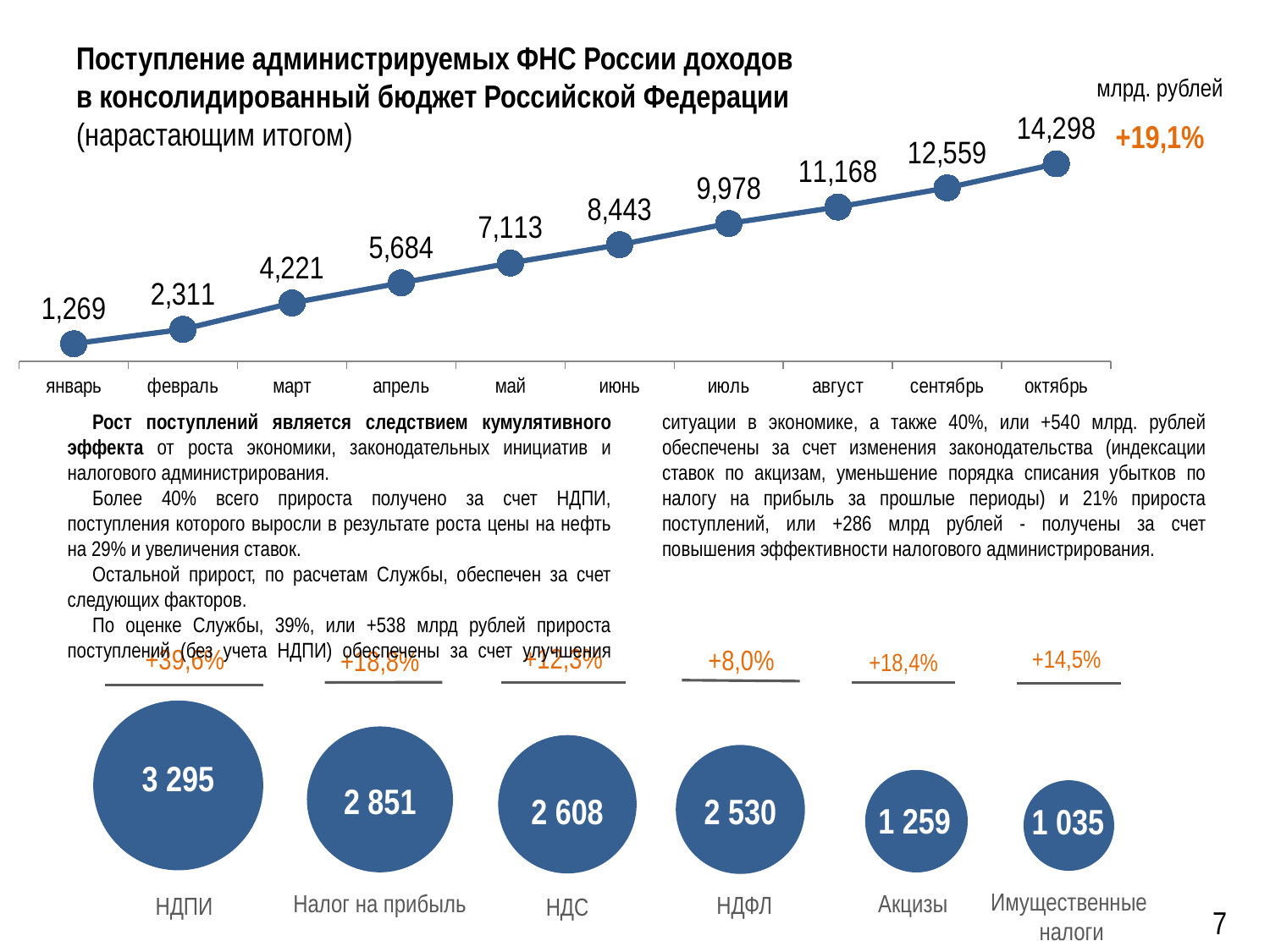
In the top line chart, what is the value shown for октябрь (October)? 14,298 In the bottom bubble chart, what is the value for НДФЛ? 2 530 In the top line chart, what growth percentage is shown in orange next to the last point? +19,1% In the top line chart, what is the cumulative value for май (May)? 7,113 In the top line chart, do the values rise or fall from январь to октябрь? rise In the bottom bubble chart, which tax has the highest value? НДПИ In the top line chart, how many months are plotted? 10 In the bottom bubble chart, what growth percentage is shown above Акцизы? +18,4% In the bottom bubble chart, which tax has the lowest value? Имущественные налоги What type of chart is the top chart on the slide? line chart In the top line chart, what is the value for январь (January)? 1,269 In the top line chart, what is the difference between the values for апрель and март? 1,463